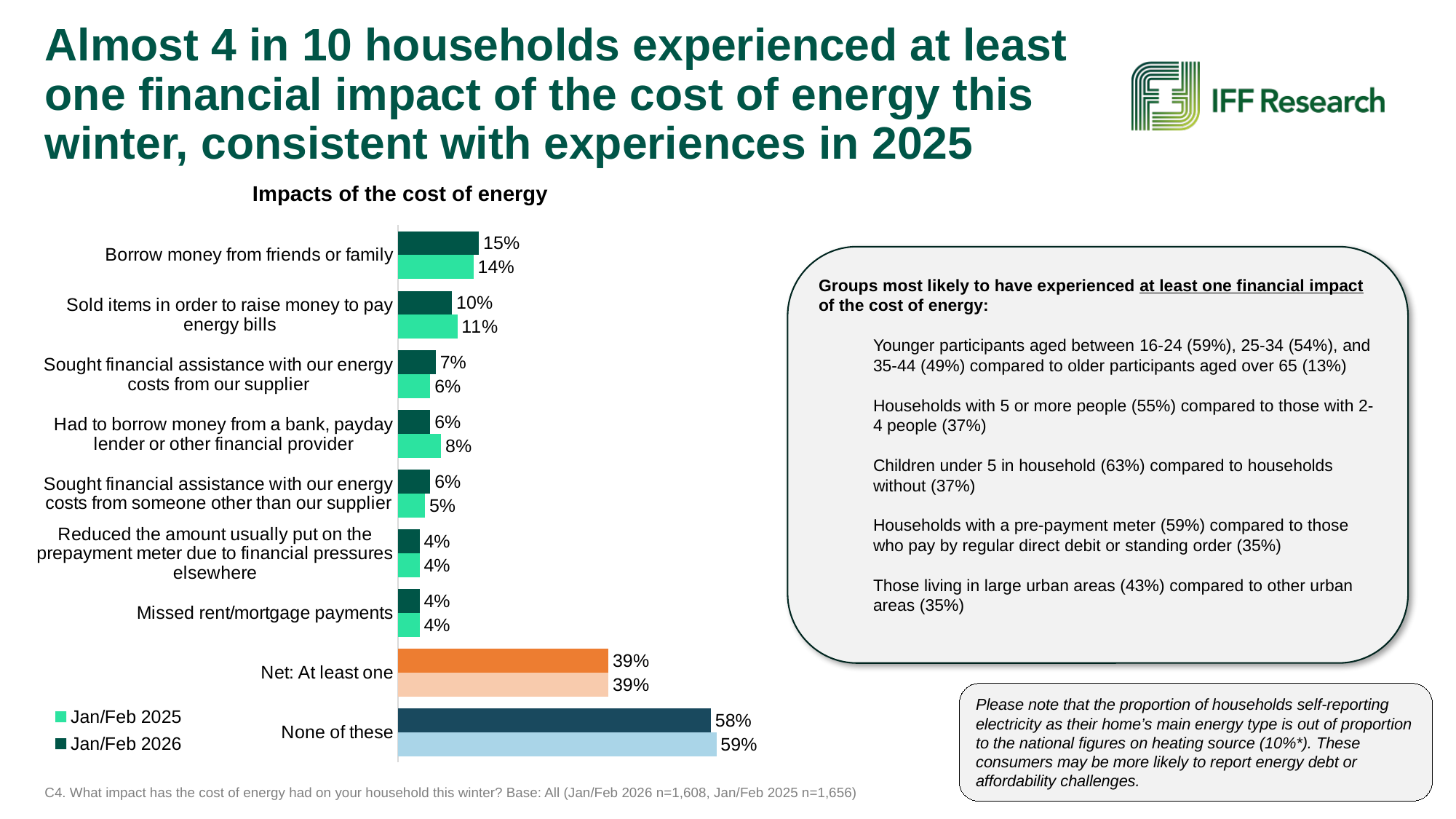
How many categories are shown on the chart, including the Net and None rows? 9 What kind of chart is shown on the slide? Bar chart What is the Jan/Feb 2026 value for 'Borrow money from friends or family'? 15% Among the seven individual impacts (excluding the Net and None rows), which has the highest Jan/Feb 2026 value? Borrow money from friends or family What is the difference between the Jan/Feb 2025 and Jan/Feb 2026 values for 'Had to borrow money from a bank, payday lender or other financial provider'? 2 percentage points For 'Sought financial assistance with our energy costs from our supplier', which year has the larger value, Jan/Feb 2025 or Jan/Feb 2026? Jan/Feb 2026 What is the Jan/Feb 2026 value for 'Missed rent/mortgage payments'? 4% What is the title of the chart? Impacts of the cost of energy What is the Jan/Feb 2026 value for 'Net: At least one'? 39% What is the Jan/Feb 2025 value for 'Sold items in order to raise money to pay energy bills'? 11% How many series does the legend list? 2 What is the Jan/Feb 2025 value for 'None of these'? 59%